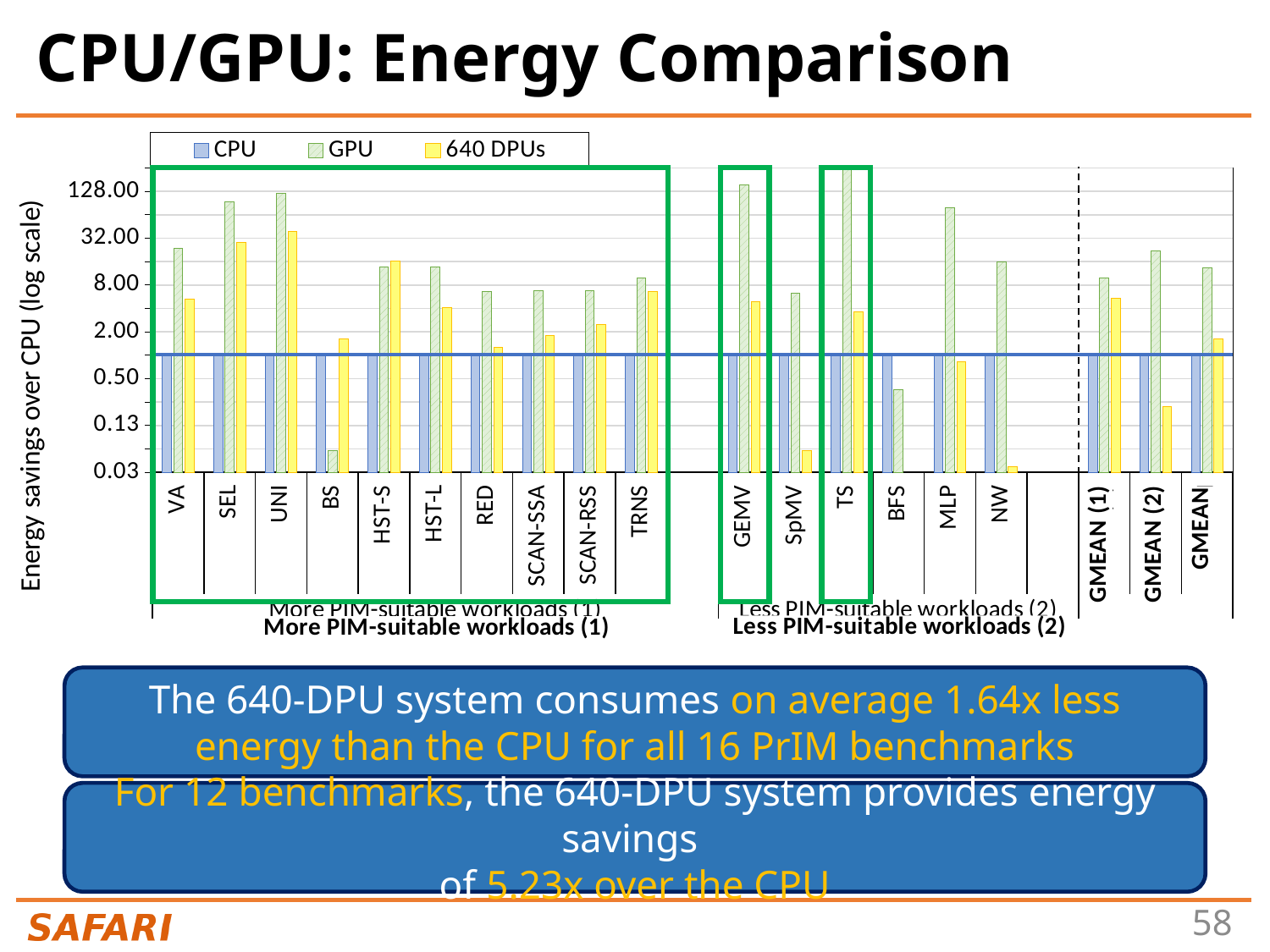
What are the three series named in the legend? CPU, GPU, 640 DPUs Is the 640 DPUs value for GMEAN (2) greater or less than 0.50? less Is the GPU value for MLP greater or less than 32.00? greater What kind of chart is shown on the slide? bar chart Is the 640 DPUs value for SpMV greater or less than 0.13? less Which workload has the lowest GPU bar? BS For GEMV, which is larger: the GPU value or the 640 DPUs value? GPU Which workload has the highest GPU bar? TS How many series does the legend list? 3 What is the label of the y axis? Energy savings over CPU (log scale)